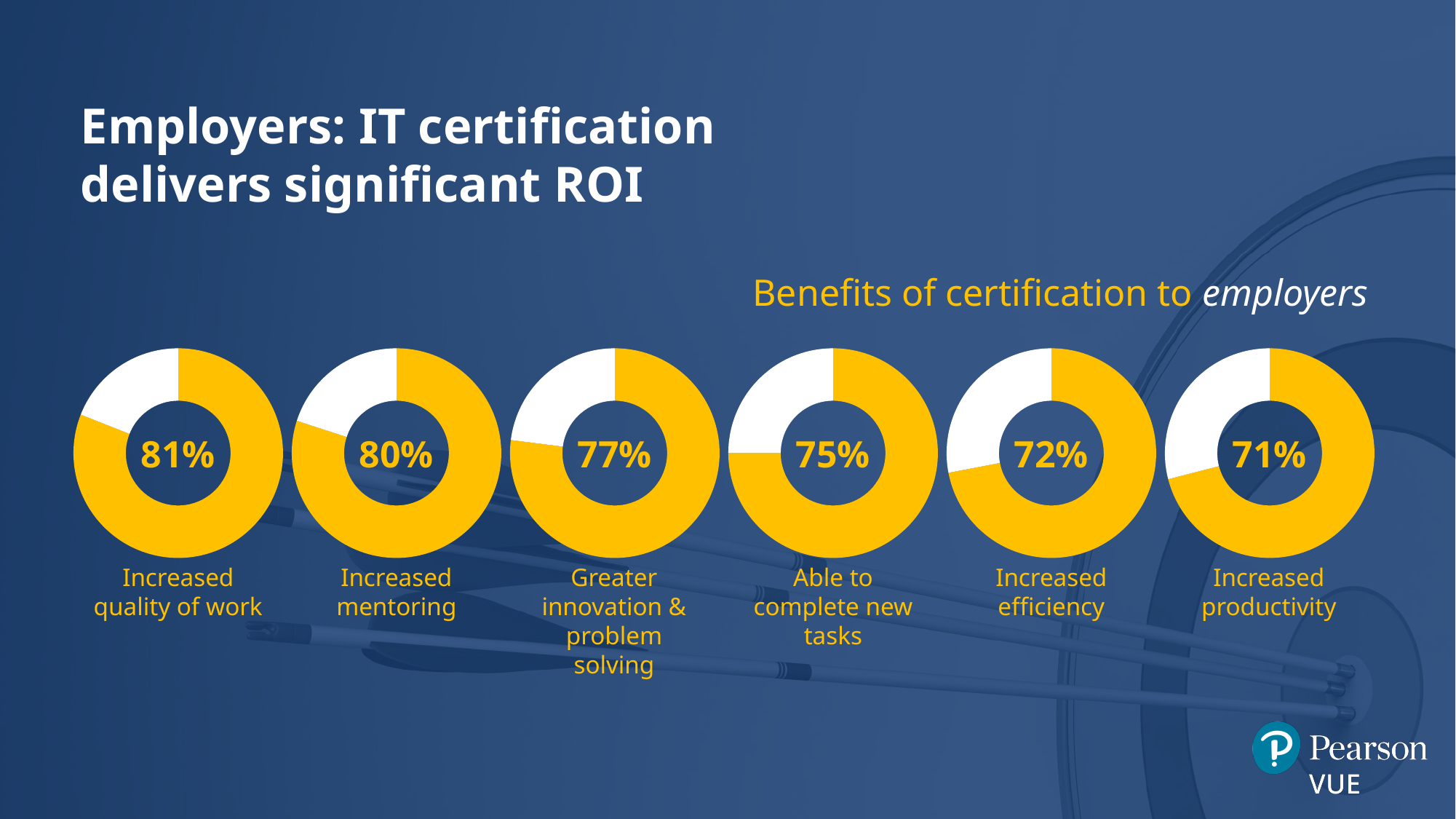
What percentage is shown for Greater innovation & problem solving? 77% What percentage is shown for Increased productivity? 71% Which benefit has the highest percentage? Increased quality of work Which benefit has the lowest percentage? Increased productivity How many donut charts are shown on the slide? 6 What kind of charts are used to show the benefits of certification? Donut (pie) charts What is the difference between the percentages for Increased quality of work and Increased productivity? 10% What percentage is shown for Increased efficiency? 72% What percentage is shown for Increased quality of work? 81% What percentage is shown for Increased mentoring? 80% What percentage is shown for Able to complete new tasks? 75% What is the title above the charts? Benefits of certification to employers